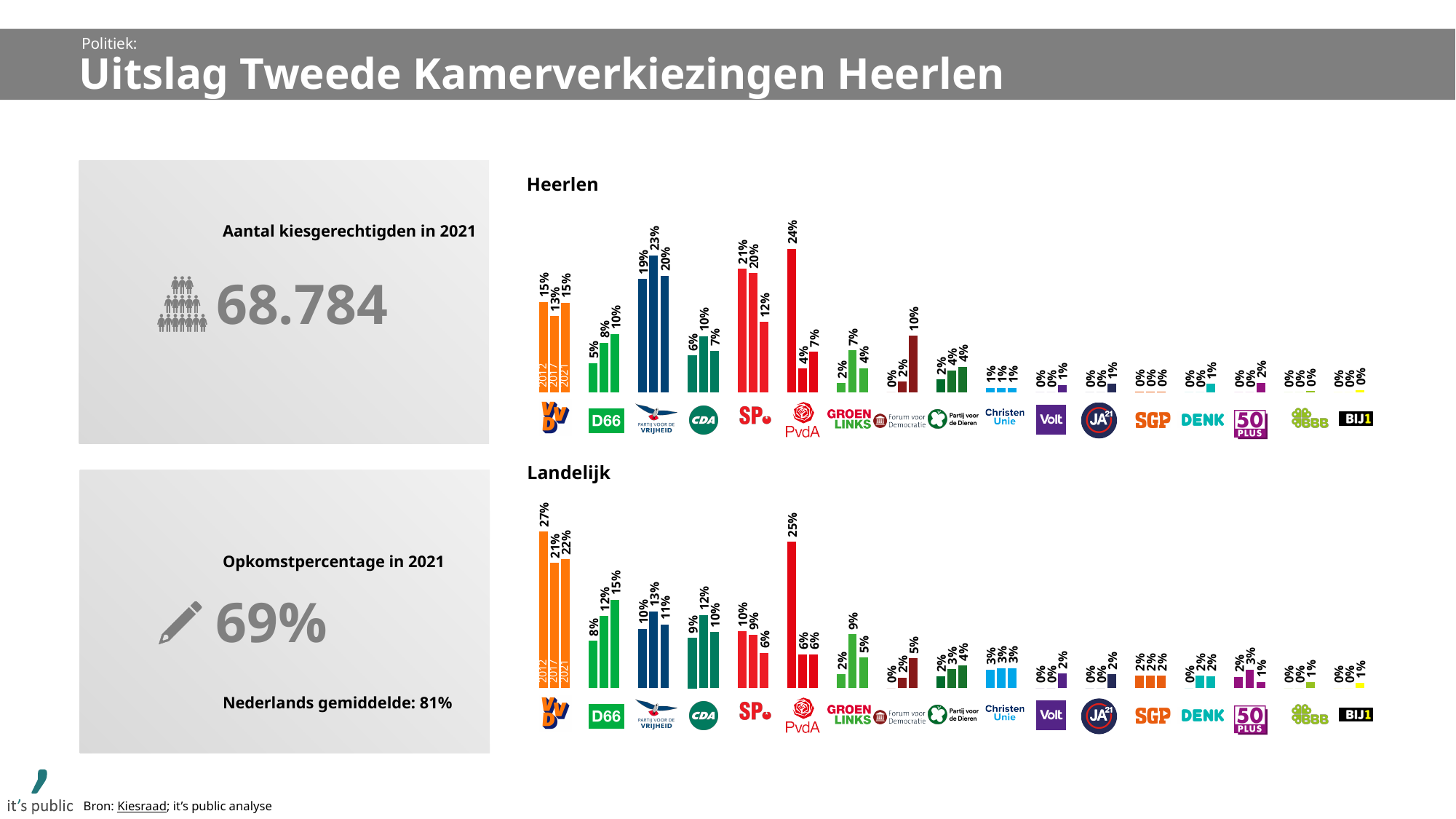
What type of chart is the Landelijk chart? Bar chart In the Heerlen chart, what percentage did PvdA get in 2012? 24% In the Landelijk chart, which party had the highest percentage in 2021? VVD How many years (series) are shown for each party in the Heerlen chart? 3 In the Heerlen chart, what is the difference between the SP result in 2012 and in 2021? 9% In the Landelijk chart, what percentage did VVD get in 2012? 27% In the Landelijk chart, what is the difference between the PvdA result in 2012 and in 2017? 19% In the Heerlen chart, which is larger: the 2021 value for Forum voor Democratie or the 2021 value for D66? They are equal (10%) In the Heerlen chart, which party had the highest percentage in 2021? PVV (Partij voor de Vrijheid) In the Heerlen chart, do the D66 values rise or fall from 2012 to 2021? Rise In the Landelijk chart, what percentage did D66 get in 2021? 15% In the Heerlen chart, what percentage did PVV (Partij voor de Vrijheid) get in 2017? 23%